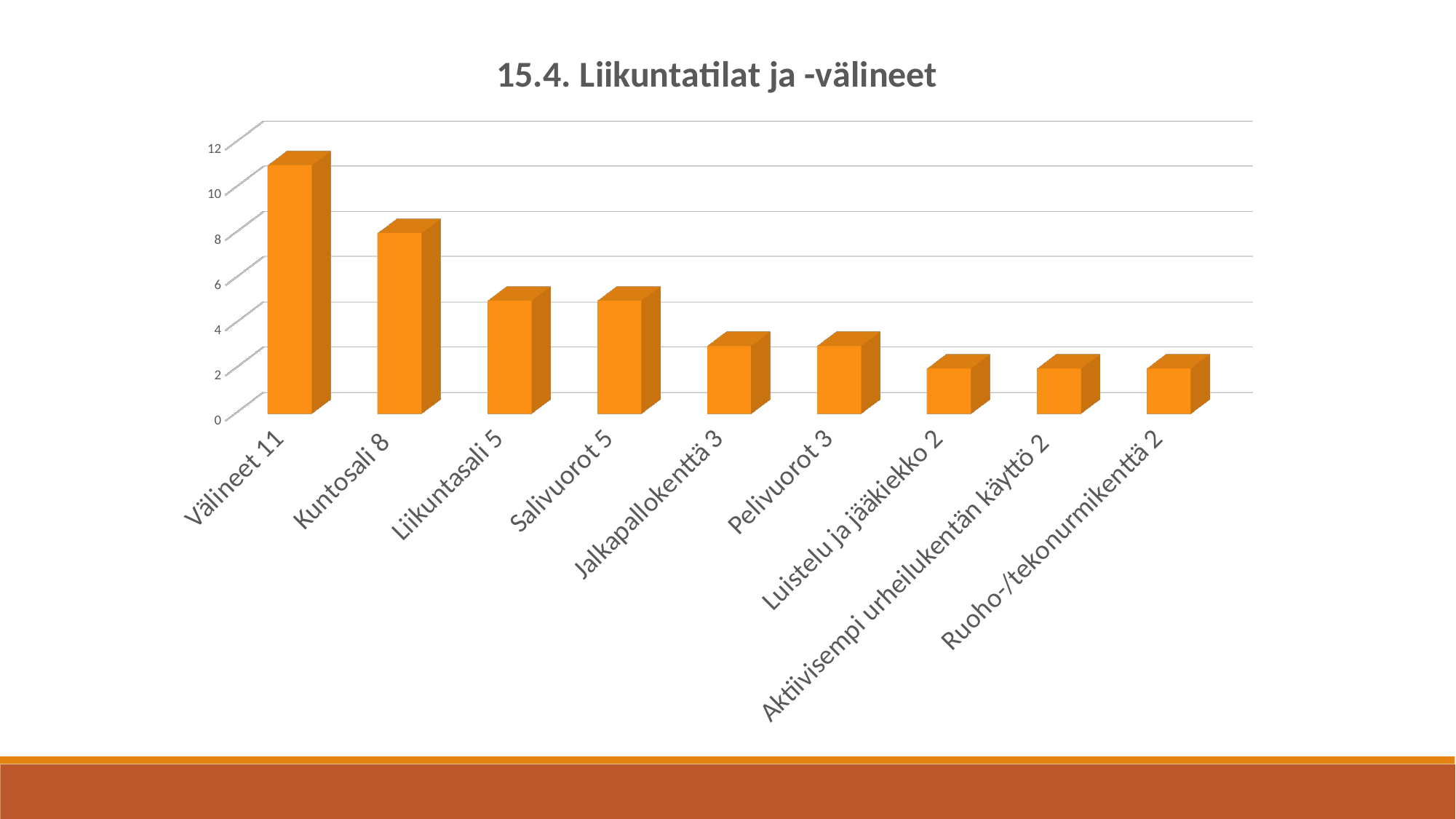
What is the title of the chart? 15.4. Liikuntatilat ja -välineet What kind of chart is shown on the slide? Bar chart What is the difference between the values for Välineet and Kuntosali? 3 Is the value for Salivuorot greater or less than 8? less Which is larger, the value for Liikuntasali or the value for Luistelu ja jääkiekko? Liikuntasali What is the difference between the values for Kuntosali and Pelivuorot? 5 Which category has the highest value? Välineet What is the value for Kuntosali? 8 What is the value for Jalkapallokenttä? 3 How many categories are shown in the chart? 9 Is the value for Kuntosali greater or less than 6? greater What is the value for Välineet? 11